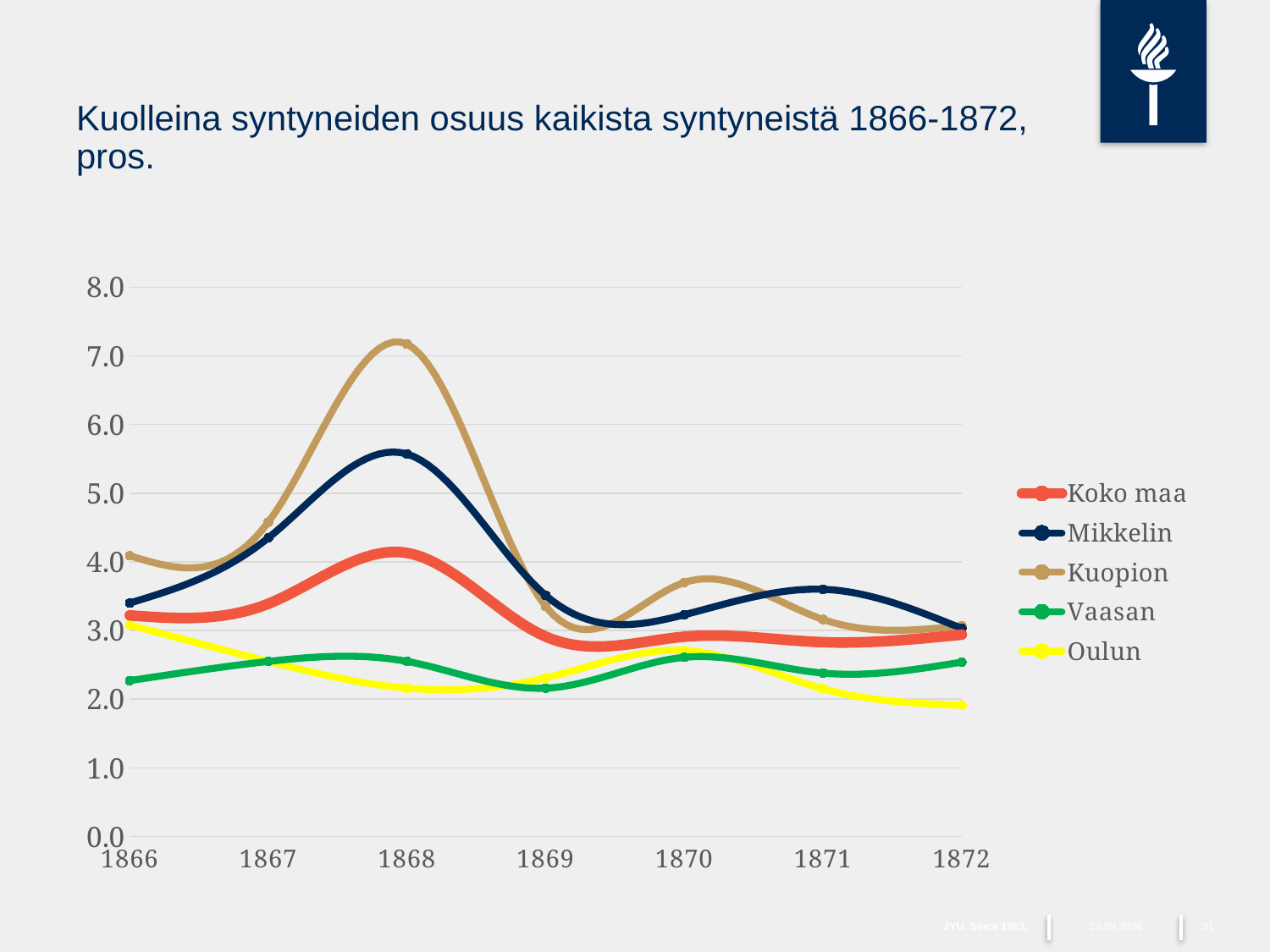
How many years are plotted along the x axis? 7 What kind of chart is shown on the slide? line chart What colour is the Vaasan line? green Is the value for Kuopion in 1868 greater or less than 7.0? greater Is the value for Vaasan in 1866 greater or less than 3.0? less Which series has the highest value in 1871? Mikkelin In 1868, which is larger: the value for Mikkelin or the value for Koko maa? Mikkelin Does the Oulun line rise or fall from 1866 to 1872? fall Is the value for Mikkelin in 1868 greater or less than 5.0? greater Which series has the highest value in 1868? Kuopion Which series has the lowest value in 1872? Oulun How many series does the legend list? 5